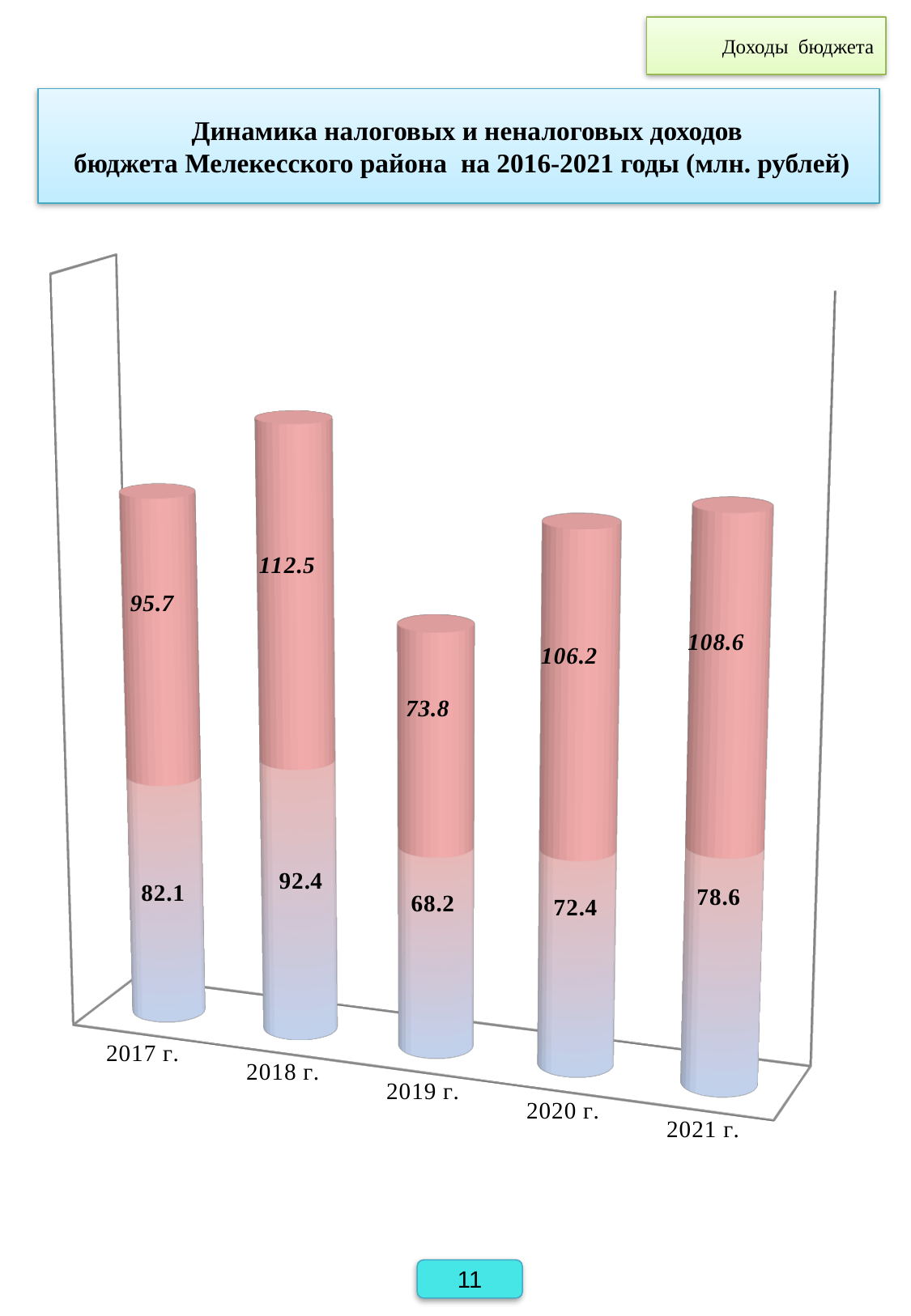
What is the total of the stacked bar for 2019 г.? 142.0 What value is printed on the upper (pink) segment of the bar for 2020 г.? 106.2 Which year has the lowest value in the lower (blue) segment? 2019 г. What is the total of the stacked bar for 2021 г.? 187.2 What value is printed on the lower (blue) segment of the bar for 2018 г.? 92.4 What kind of chart is shown on the slide? Stacked bar chart What is the difference between the upper (pink) segment values for 2018 г. and 2019 г.? 38.7 What value is printed on the upper (pink) segment of the bar for 2019 г.? 73.8 Which year has the highest value in the upper (pink) segment? 2018 г. How many years are shown on the x axis of the chart? 5 Which is larger: the lower (blue) segment value for 2017 г. or for 2021 г.? 2017 г. What unit of measurement is stated in the chart title? млн. рублей